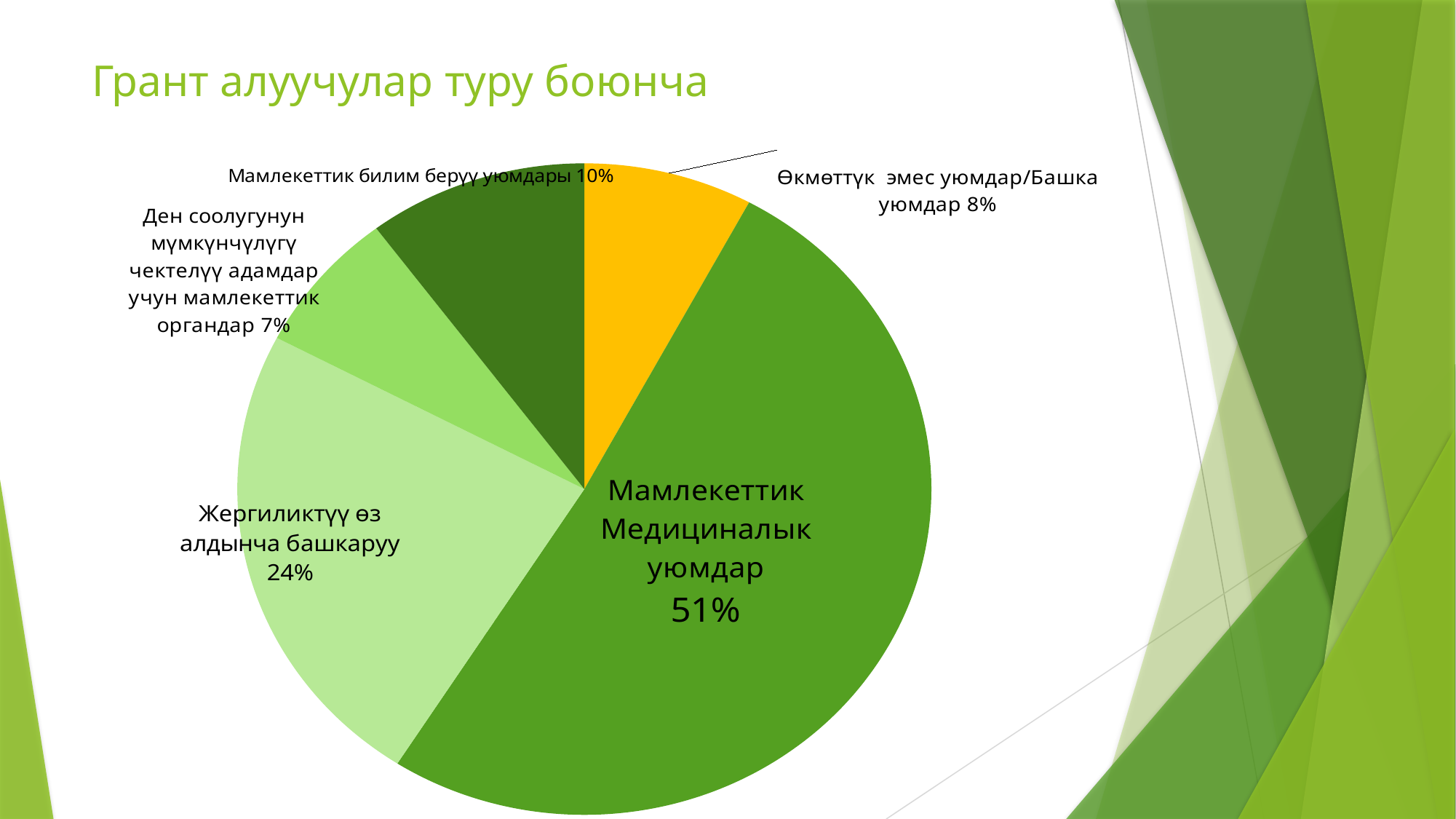
Which is larger, the slice for Мамлекеттик билим берүү уюмдары or the slice for Өкмөттүк эмес уюмдар/Башка уюмдар? Мамлекеттик билим берүү уюмдары How many slices does the pie chart have? 5 Which category has the smallest slice of the pie? Ден соолугунун мүмкүнчүлүгү чектелүү адамдар учун мамлекеттик органдар What share of the pie is labelled for Жергиликтүү өз алдынча башкаруу? 24% What is the title of the chart on the slide? Грант алуучулар туру боюнча What share of the pie is labelled for Мамлекеттик билим берүү уюмдары? 10% Which category has the largest slice of the pie? Мамлекеттик Медициналык уюмдар What is the difference in percentage points between Мамлекеттик Медициналык уюмдар and Жергиликтүү өз алдынча башкаруу? 27 percentage points What share of the pie is labelled for Мамлекеттик Медициналык уюмдар? 51% What share of the pie is labelled for Ден соолугунун мүмкүнчүлүгү чектелүү адамдар учун мамлекеттик органдар? 7% What share of the pie is labelled for Өкмөттүк эмес уюмдар/Башка уюмдар? 8% What kind of chart is shown on the slide? Pie chart